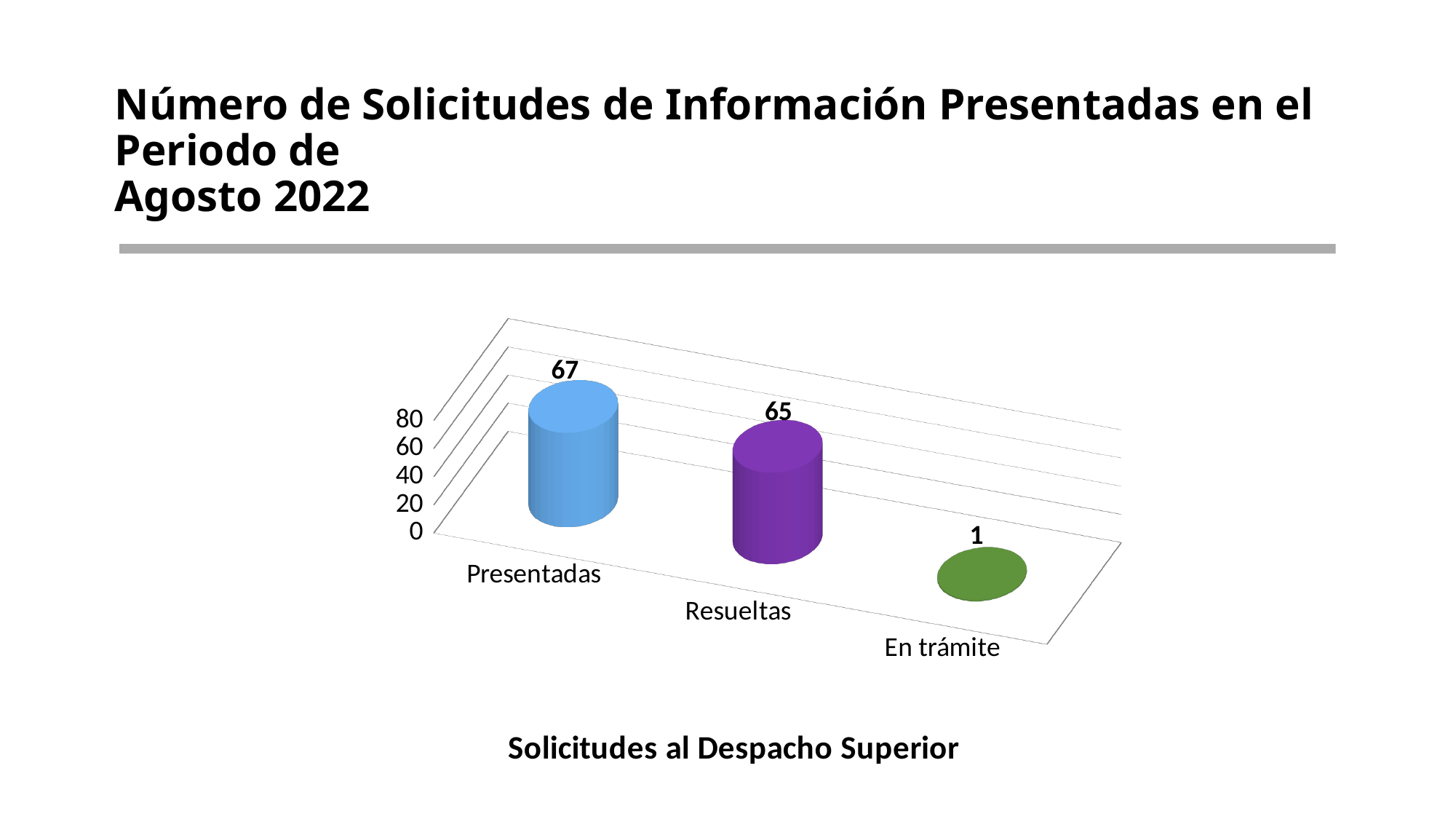
Is the value for Presentadas greater or less than 60? greater What kind of chart is shown on the slide? bar chart What is the difference between the values for Presentadas and Resueltas? 2 What is the value for Presentadas? 67 What is the value for En trámite? 1 Which category has the highest value? Presentadas What is the title shown below the chart? Solicitudes al Despacho Superior What is the value for Resueltas? 65 What is the difference between the values for Resueltas and En trámite? 64 Which category has the lowest value? En trámite Which is larger, the value for Resueltas or the value for En trámite? Resueltas How many categories are shown on the chart? 3